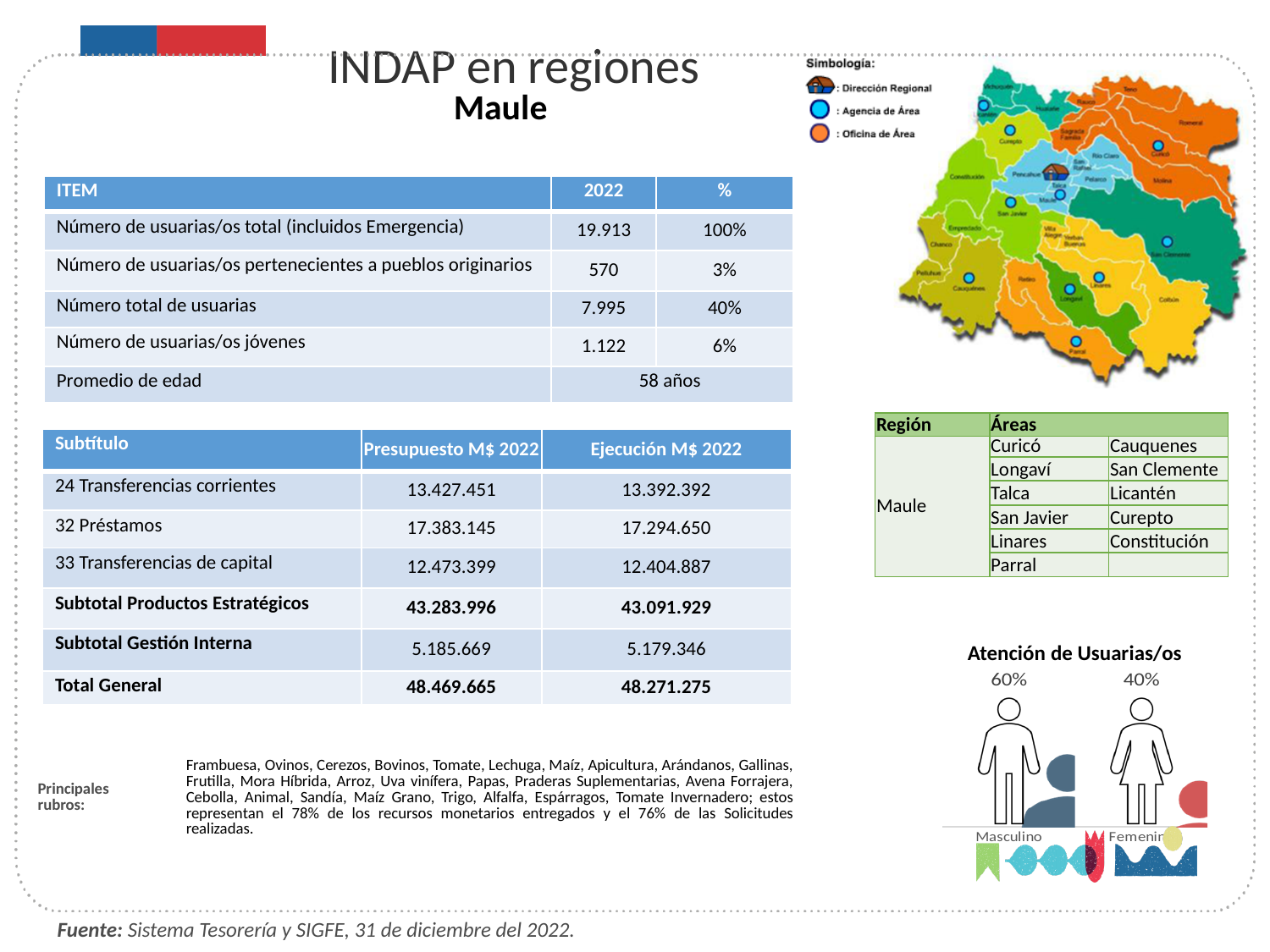
In the 'Atención de Usuarias/os' chart, which is larger, Masculino or Femenino? Masculino In the 'Atención de Usuarias/os' chart, what is the value for Femenino? 40% What is the title of the chart in the lower right of the slide? Atención de Usuarias/os How many categories are shown in the 'Atención de Usuarias/os' chart? 2 In the 'Atención de Usuarias/os' chart, what do the Masculino and Femenino values add up to? 100% What kind of chart is 'Atención de Usuarias/os'? Pictogram chart In the 'Atención de Usuarias/os' chart, what is the value for Masculino? 60% In the 'Atención de Usuarias/os' chart, which category has the lowest value? Femenino In the 'Atención de Usuarias/os' chart, what is the difference between the Masculino and Femenino values? 20% In the 'Atención de Usuarias/os' chart, which category has the highest value? Masculino